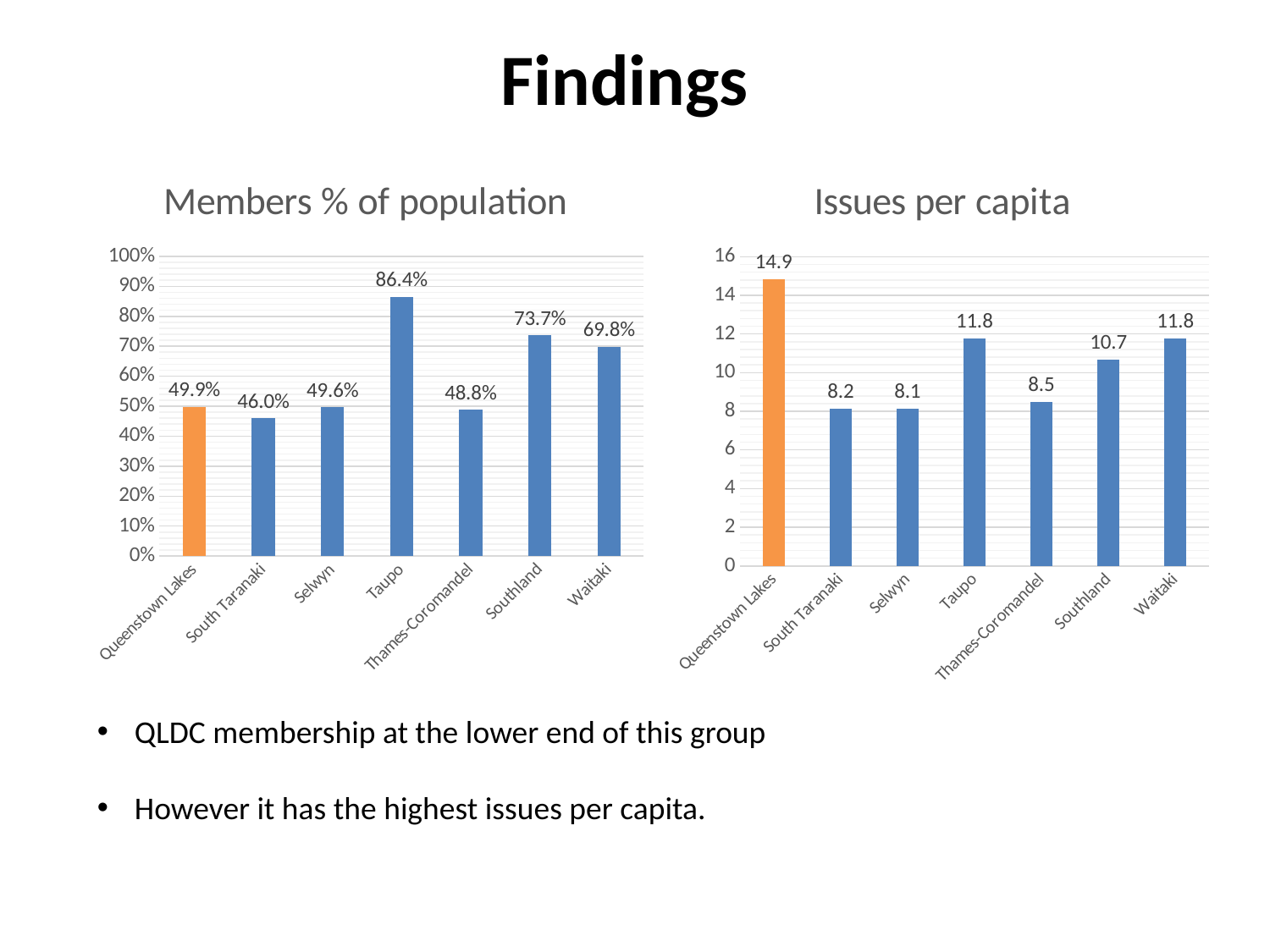
In the 'Issues per capita' chart, which category has the highest value? Queenstown Lakes What kind of chart is the 'Issues per capita' chart? Bar chart In the 'Members % of population' chart, which is larger, Queenstown Lakes or Thames-Coromandel? Queenstown Lakes In the 'Issues per capita' chart, what is the value for Selwyn? 8.1 In the 'Members % of population' chart, what is the value for Taupo? 86.4% In the 'Members % of population' chart, how many categories are shown? 7 In the 'Members % of population' chart, what is the difference between Southland and Waitaki? 3.9% In the 'Issues per capita' chart, what is the value for Queenstown Lakes? 14.9 In the 'Issues per capita' chart, is the value for Thames-Coromandel greater or less than 10? less In the 'Members % of population' chart, which category has the lowest value? South Taranaki In the 'Issues per capita' chart, what is the difference between Queenstown Lakes and Southland? 4.2 In the 'Members % of population' chart, which bar is coloured orange? Queenstown Lakes